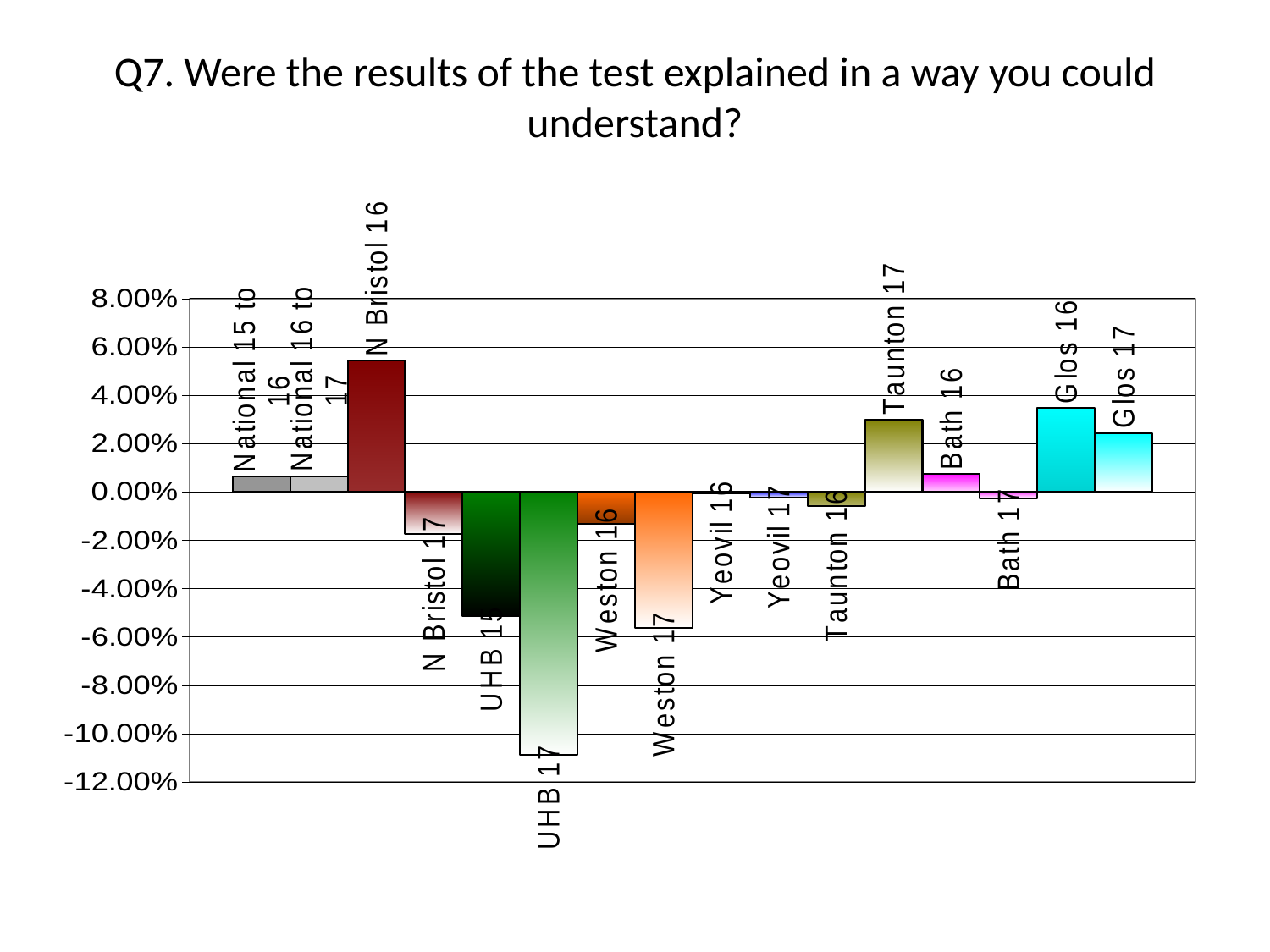
Which category has the lowest value in the chart? UHB 17 Is the value for Glos 16 greater or less than 2.00%? greater Is the value for UHB 17 greater or less than -10.00%? less Is the value for N Bristol 16 greater or less than 4.00%? greater What is the title of the chart on the slide? Q7. Were the results of the test explained in a way you could understand? Which is larger, the value for Taunton 17 or the value for Bath 16? Taunton 17 What kind of chart is shown on the slide? bar chart Which category has the highest value in the chart? N Bristol 16 How many categories (bars) are plotted in the chart? 16